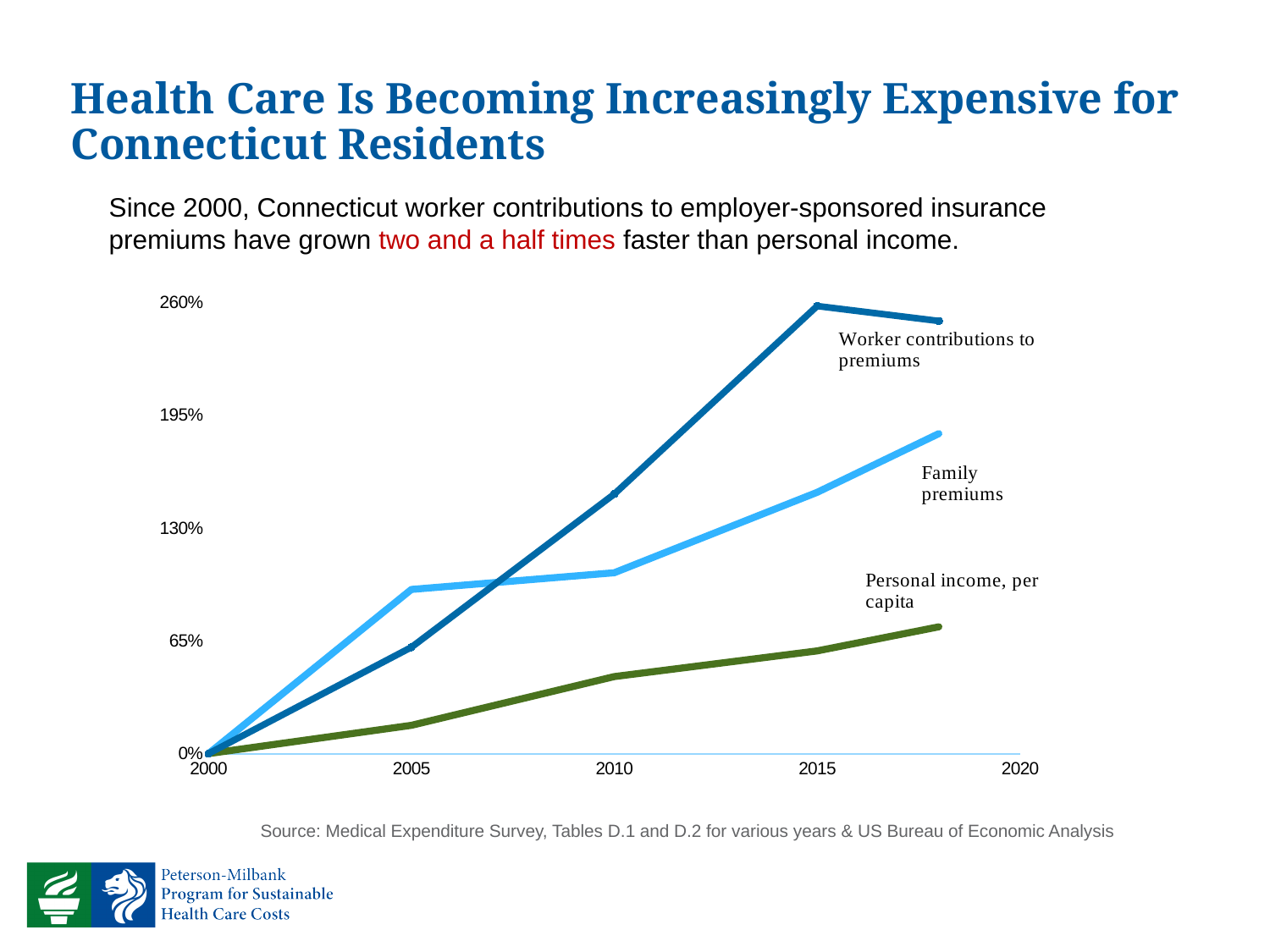
Which series reaches the highest value on the chart? Worker contributions to premiums What is the value of all three series in 2000? 0% How many series are plotted on the chart? 3 In 2015, which is higher: Worker contributions to premiums or Family premiums? Worker contributions to premiums Does the Personal income, per capita line rise or fall from 2000 to the end of the series? rises Is the value for Worker contributions to premiums in 2015 greater or less than 195%? greater Is the value for Personal income, per capita in 2010 greater or less than 65%? less In 2005, which is higher: Family premiums or Worker contributions to premiums? Family premiums Is the value for Family premiums in 2010 greater or less than 65%? greater Which series has the lowest values across the chart? Personal income, per capita What kind of chart is shown on the slide? line chart